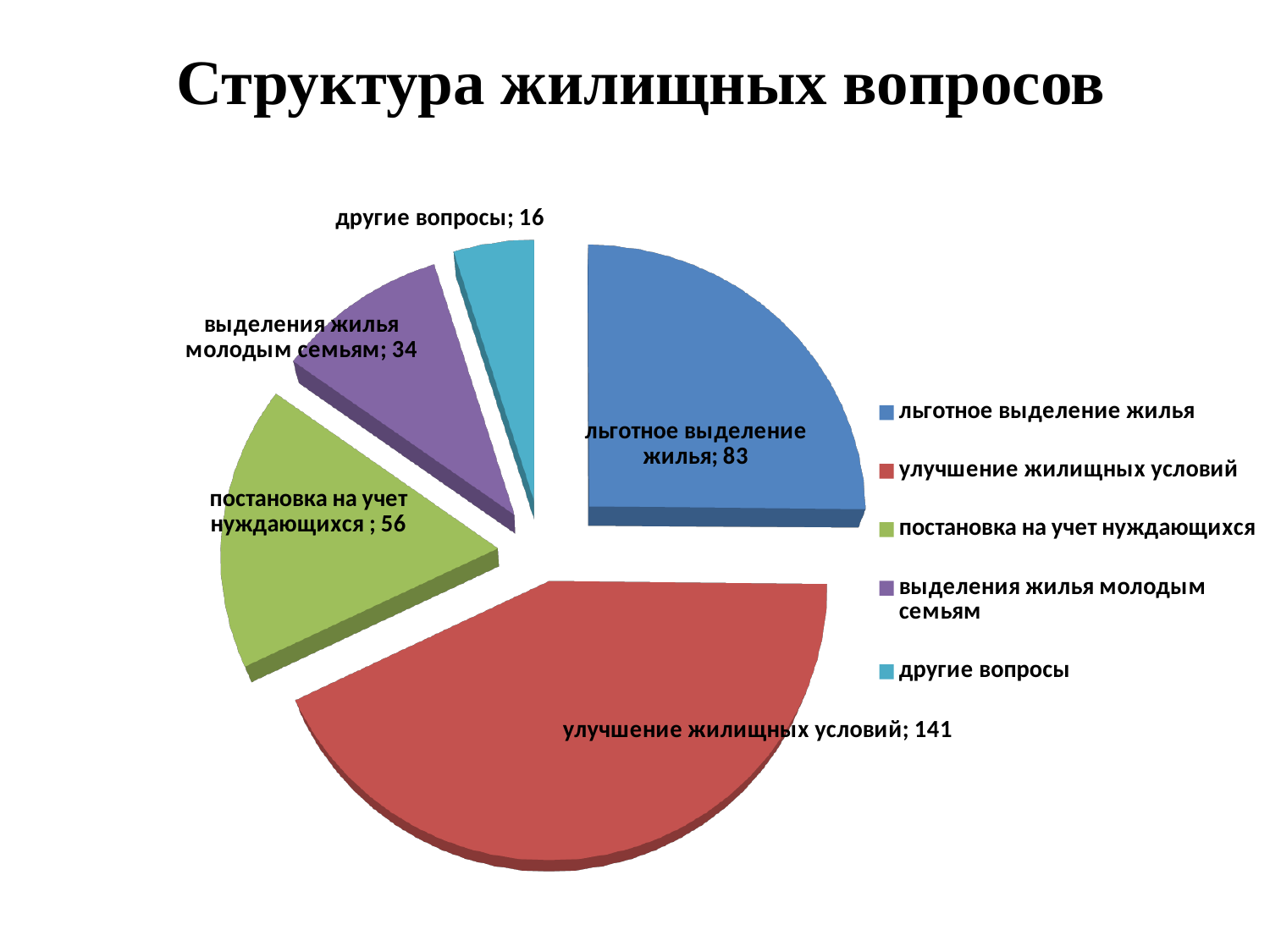
What is the value for постановка на учет нуждающихся? 56 Which category has the smallest slice of the pie? другие вопросы What is the difference between the values for улучшение жилищных условий and льготное выделение жилья? 58 How many categories does the pie chart have? 5 What is the value for другие вопросы? 16 Which is larger: постановка на учет нуждающихся or выделения жилья молодым семьям? постановка на учет нуждающихся What is the value for льготное выделение жилья? 83 What type of chart is shown on the slide? Pie chart What is the title of the slide? Структура жилищных вопросов What is the value for улучшение жилищных условий? 141 Which category has the largest slice of the pie? улучшение жилищных условий What is the total of all slices in the pie chart? 330